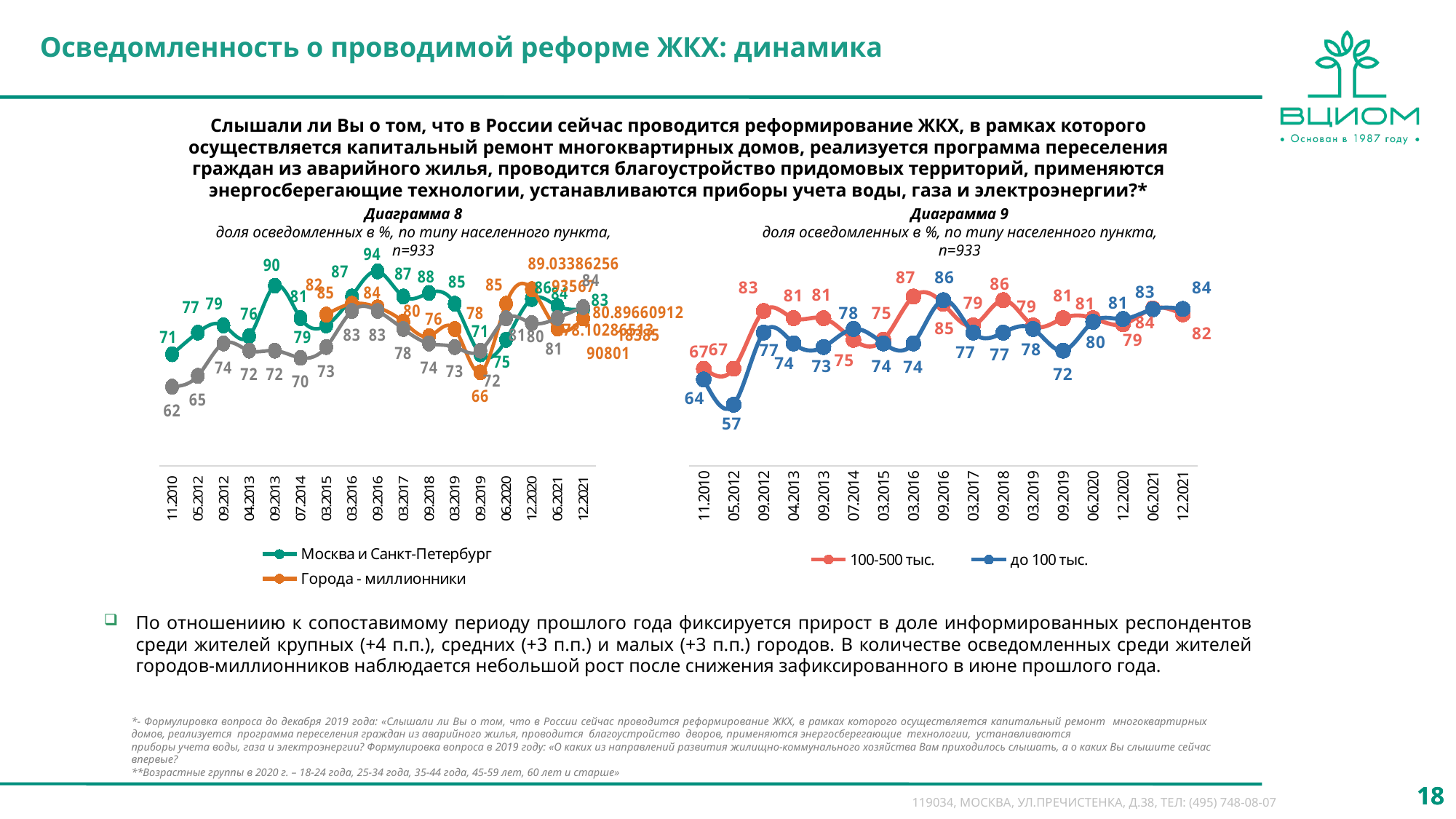
In Диаграмма 8, what is the value for 'Москва и Санкт-Петербург' at 12.2021? 83 How many time points are shown on the x axis of Диаграмма 9? 17 In Диаграмма 9, at which date is the 'до 100 тыс.' series at its lowest? 05.2012 In Диаграмма 9, what is the value for 'до 100 тыс.' at 05.2012? 57 In Диаграмма 9, what is the highest value of the 'до 100 тыс.' series? 86 In Диаграмма 8, at which date does the 'Москва и Санкт-Петербург' series reach its highest value? 09.2016 How many series does the legend of Диаграмма 9 list? 2 In Диаграмма 9, what is the difference between 'до 100 тыс.' and '100-500 тыс.' at 12.2021? 2 What kind of chart is Диаграмма 8? Line chart In Диаграмма 9, at which date does the '100-500 тыс.' series reach its highest value? 03.2016 In Диаграмма 8, what is the value for 'Москва и Санкт-Петербург' at 09.2013? 90 In Диаграмма 9, which series has the larger value at 12.2021, '100-500 тыс.' or 'до 100 тыс.'? до 100 тыс.